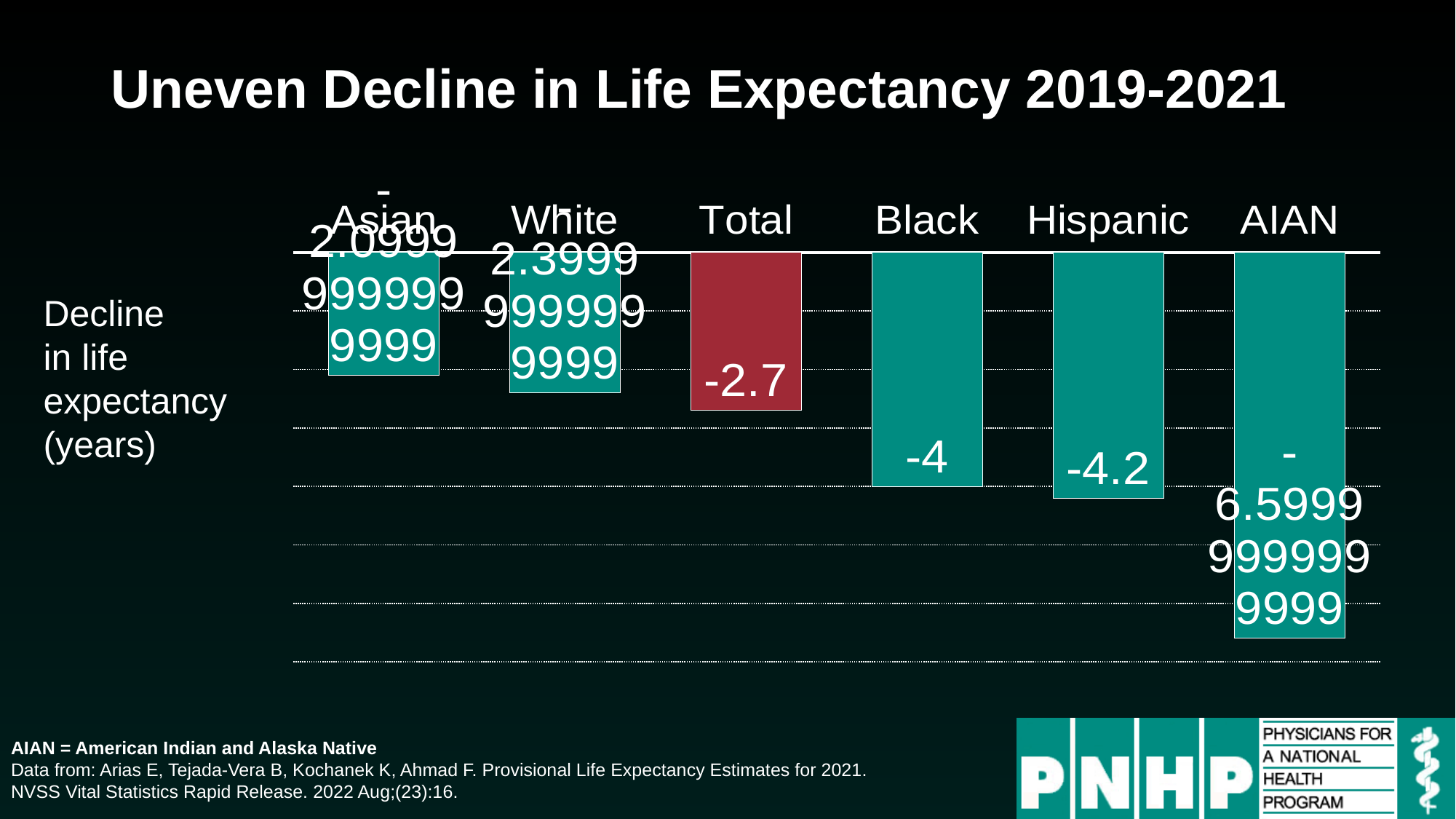
Which category's bar is coloured red rather than teal? Total How many categories are shown in the chart? 6 Which category shows the smallest decline in life expectancy? Asian Which shows a larger decline, Black or Hispanic? Hispanic What kind of chart is shown on the slide? Bar chart What is the difference between the values for Hispanic and Black? 0.2 What is the value shown for Total? -2.7 Which category shows the largest decline in life expectancy? AIAN What is the difference between the values for Black and Total? 1.3 What is the value shown for Hispanic? -4.2 What is the value shown for Black? -4 Do the declines get larger or smaller moving from left to right across the categories? Larger